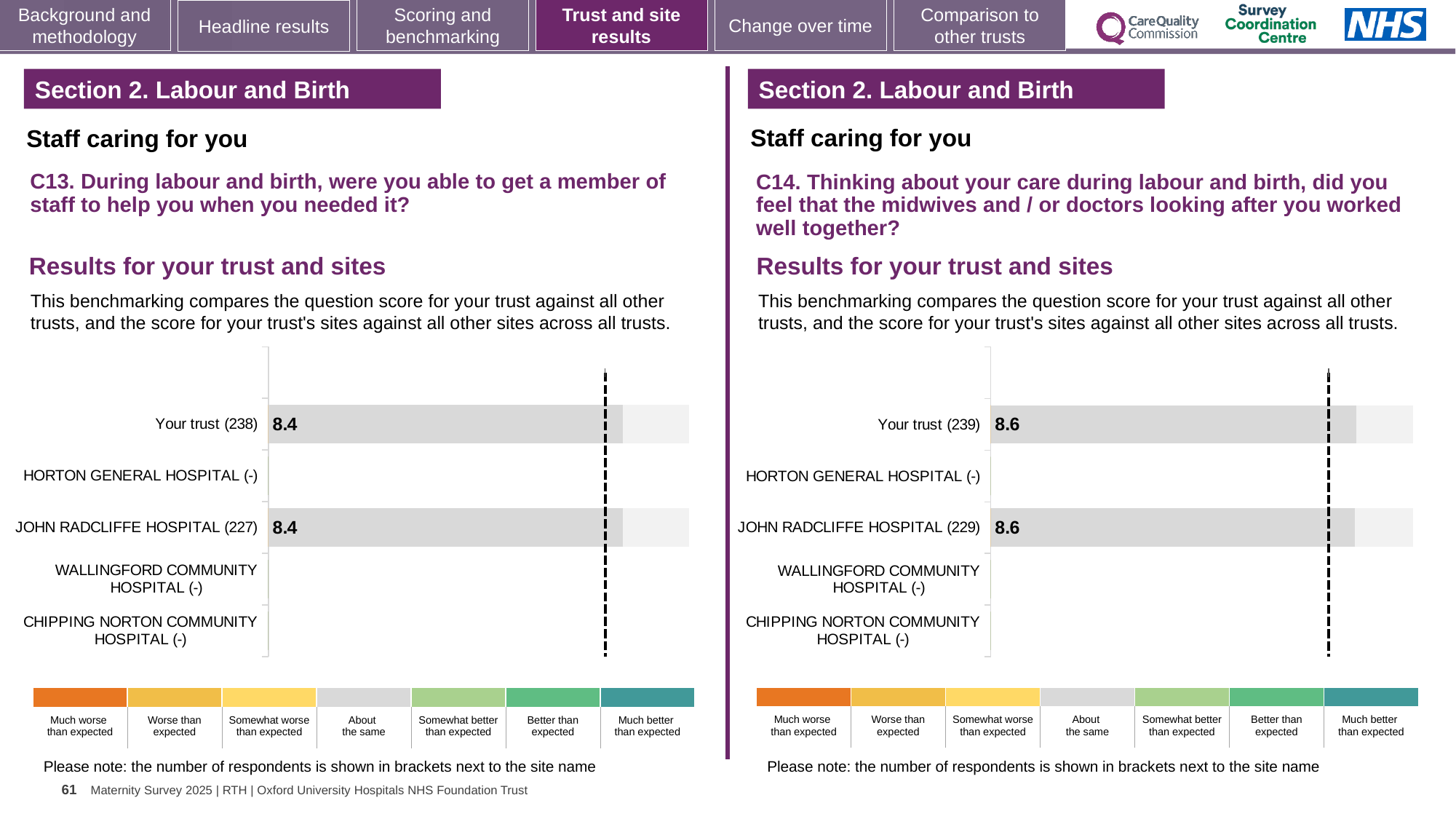
On the C14 chart (right), what is the score for Your trust? 8.6 On the C13 chart (left), which category has the highest number of respondents shown in brackets? Your trust (238) On the C14 chart (right), what is the score for John Radcliffe Hospital? 8.6 What kind of chart is the C13 chart (left)? Bar chart On the C13 chart (left), how many respondents are shown in brackets for Your trust? 238 On the C14 chart (right), how many categories have a plotted score bar? 2 On the C14 chart (right), how many respondents are shown in brackets for John Radcliffe Hospital? 229 How many site/trust categories are listed on the C14 chart (right)? 5 On the C13 chart (left), what is the score for Your trust? 8.4 On the C13 chart (left), what is the difference between the score for Your trust and the score for John Radcliffe Hospital? 0 On the C13 chart (left), what is the score for John Radcliffe Hospital? 8.4